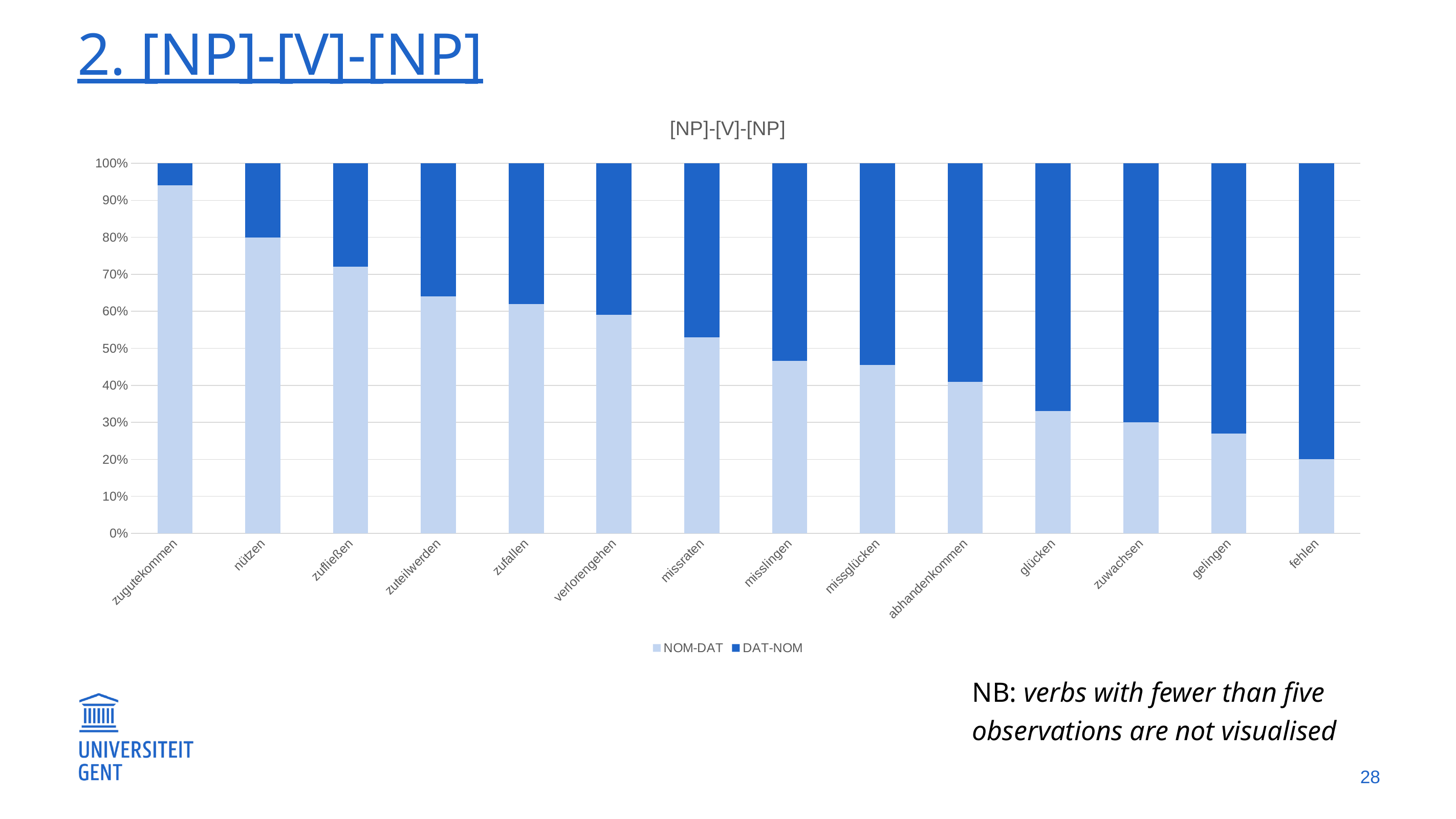
Which verb has a larger NOM-DAT share, zufließen or abhandenkommen? zufließen Which verb has the lowest NOM-DAT share? fehlen Which verb has the largest DAT-NOM share? fehlen Is the NOM-DAT share for zugutekommen greater or less than 90%? greater Which verb has the highest NOM-DAT share? zugutekommen What kind of chart is shown on the slide? bar chart Is the NOM-DAT share for missraten greater or less than 50%? greater What is the title of the chart? [NP]-[V]-[NP] How many verbs (categories) are shown on the x axis of the chart? 14 How many series does the chart legend list? 2 Does the NOM-DAT share rise or fall moving from left to right along the x axis? fall Is the NOM-DAT share for glücken greater or less than 40%? less